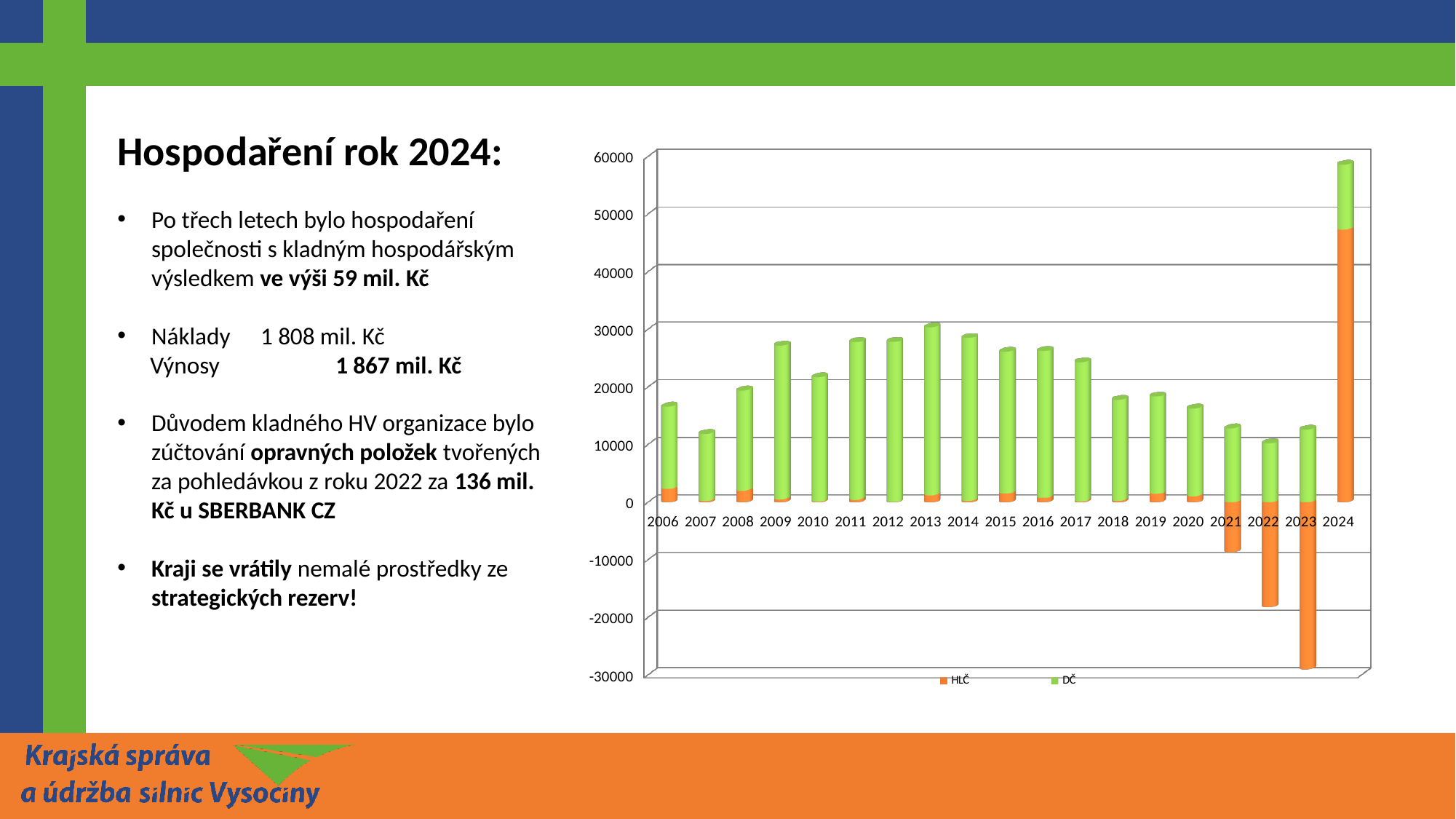
Is the top of the stacked bar for 2018 greater or less than 20000? less Is the HLČ value for 2022 greater or less than -10000? less How many series does the chart legend list? 2 How many years are shown on the x axis of the chart? 19 Is the HLČ value for 2023 greater or less than -20000? less What kind of chart is shown on the slide? bar chart Which year has the lowest (most negative) HLČ value in the chart? 2023 Do the stacked bar totals rise or fall from 2013 to 2018? fall Which year has the taller stacked bar, 2013 or 2007? 2013 Which year has the tallest stacked bar in the chart? 2024 What are the two series named in the chart legend? HLČ and DČ